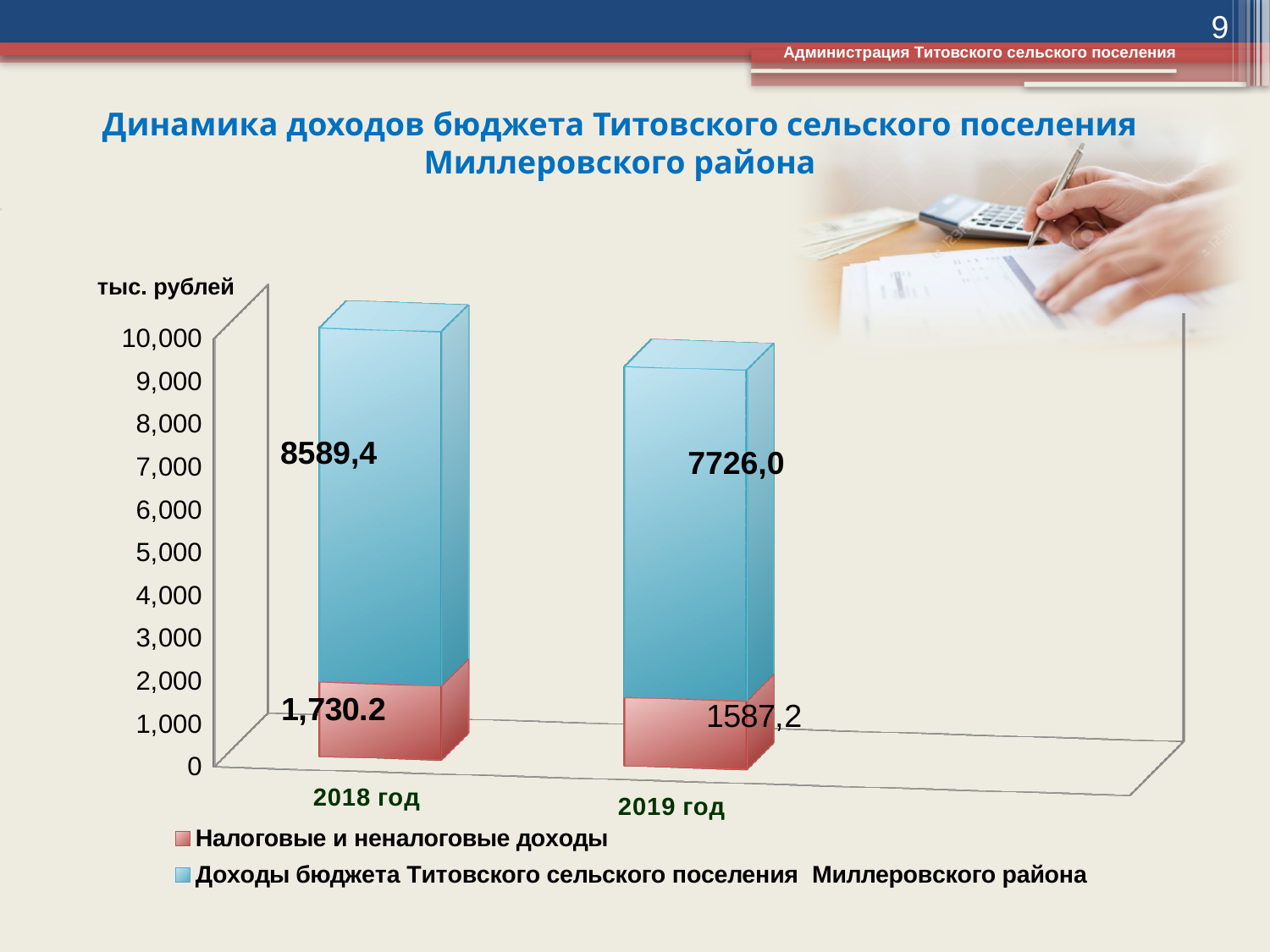
What is the value of 'Налоговые и неналоговые доходы' for 2018 год? 1,730.2 What is the value of 'Доходы бюджета Титовского сельского поселения Миллеровского района' for 2019 год? 7726,0 What unit label is shown above the vertical axis of the chart? тыс. рублей By how much does 'Доходы бюджета Титовского сельского поселения Миллеровского района' in 2018 год exceed the value in 2019 год? 863,4 What is the value of 'Доходы бюджета Титовского сельского поселения Миллеровского района' for 2018 год? 8589,4 What is the value of 'Налоговые и неналоговые доходы' for 2019 год? 1587,2 Which year has the larger value for 'Налоговые и неналоговые доходы', 2018 год or 2019 год? 2018 год Do the values of 'Доходы бюджета Титовского сельского поселения Миллеровского района' rise or fall from 2018 год to 2019 год? Fall In which year is the value of 'Доходы бюджета Титовского сельского поселения Миллеровского района' highest? 2018 год How many series does the legend list? 2 How many years are shown on the x axis of the chart? 2 What kind of chart is shown on the slide? Stacked bar chart